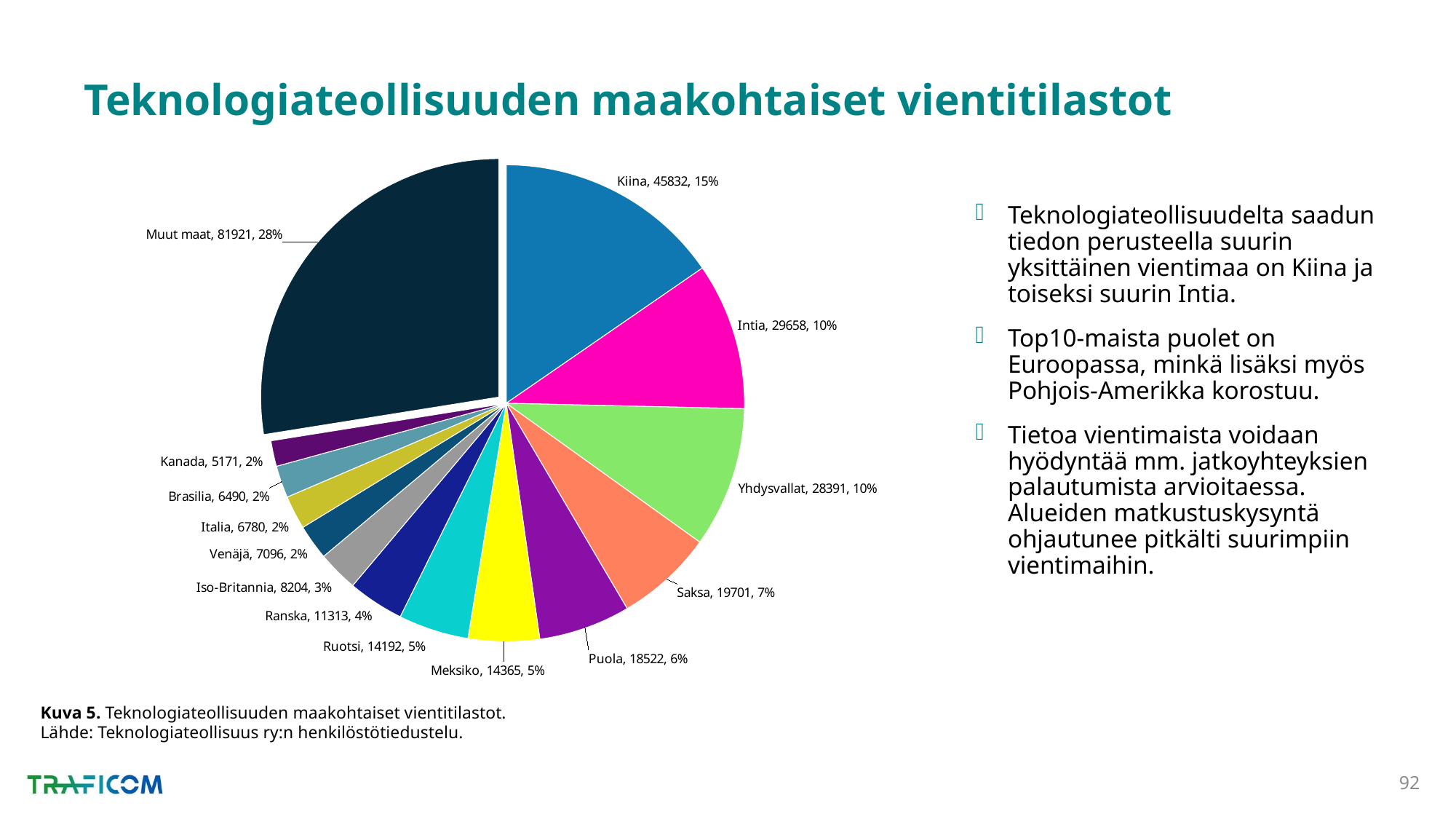
How many slices does the pie chart have? 14 What is the value for Ranska? 11313 What share of the pie does Muut maat represent? 28% Which named country has the smallest slice in the pie chart? Kanada What kind of chart is shown on the slide? Pie chart Which slice of the pie chart is the largest? Muut maat What is the difference between the values for Kiina and Intia? 16174 What is the value for Saksa? 19701 What is the value for Kiina in the pie chart? 45832 Which is larger, the value for Puola or the value for Meksiko? Puola What is the caption (Kuva 5) of the chart? Teknologiateollisuuden maakohtaiset vientitilastot. What share of the pie does Intia represent? 10%